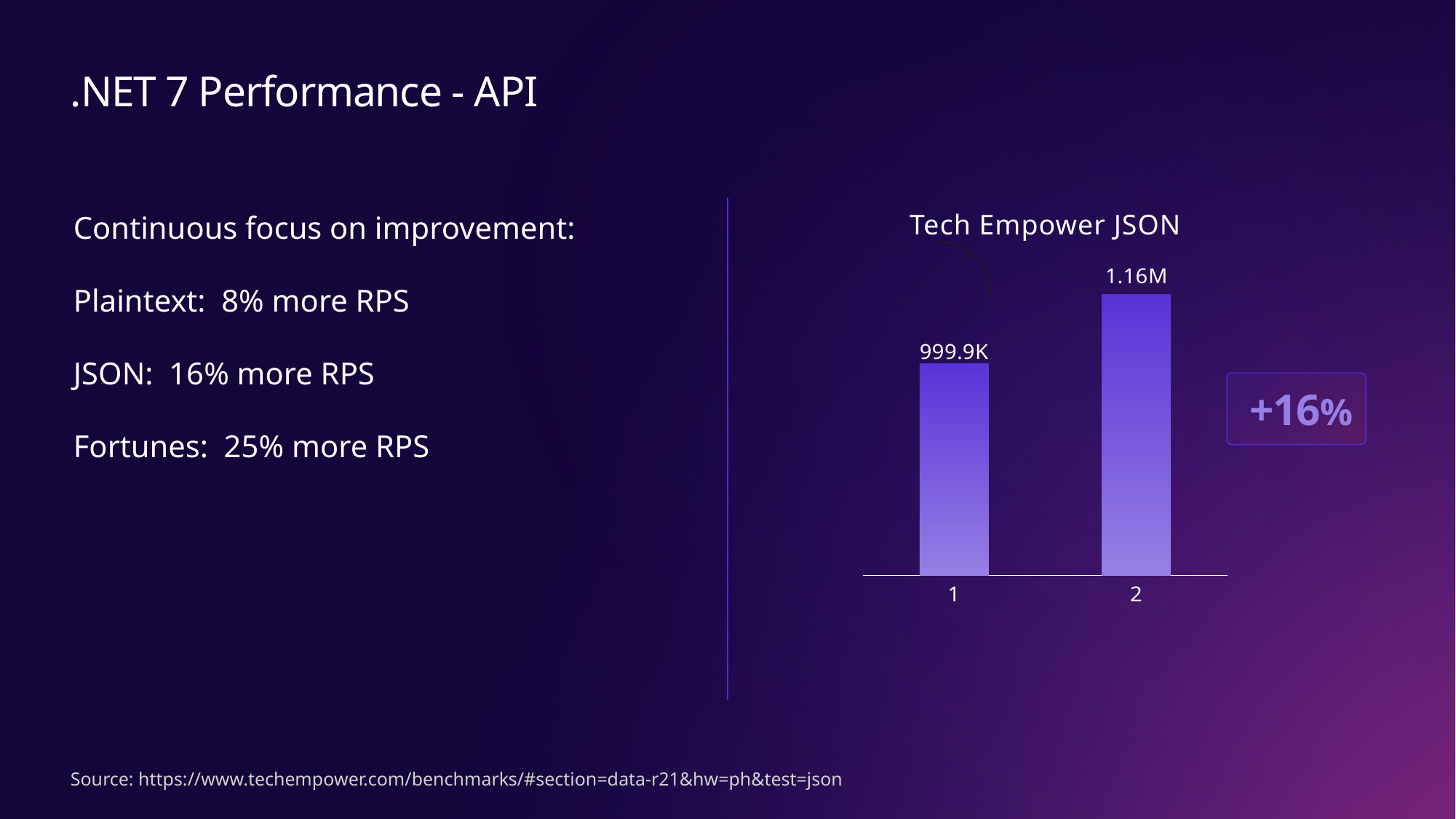
What is the value for category 1 in the Tech Empower JSON chart? 999.9K What kind of chart is the Tech Empower JSON chart? bar chart Which category has the lowest value in the Tech Empower JSON chart? 1 Do the values rise or fall from category 1 to category 2 in the Tech Empower JSON chart? rise Which category has the highest value in the Tech Empower JSON chart? 2 What is the title of the chart on the slide? Tech Empower JSON How many bars are plotted in the Tech Empower JSON chart? 2 What is the value for category 2 in the Tech Empower JSON chart? 1.16M What percentage change is shown in the box next to the Tech Empower JSON chart? +16% Is the value for category 1 or category 2 larger in the Tech Empower JSON chart? 2